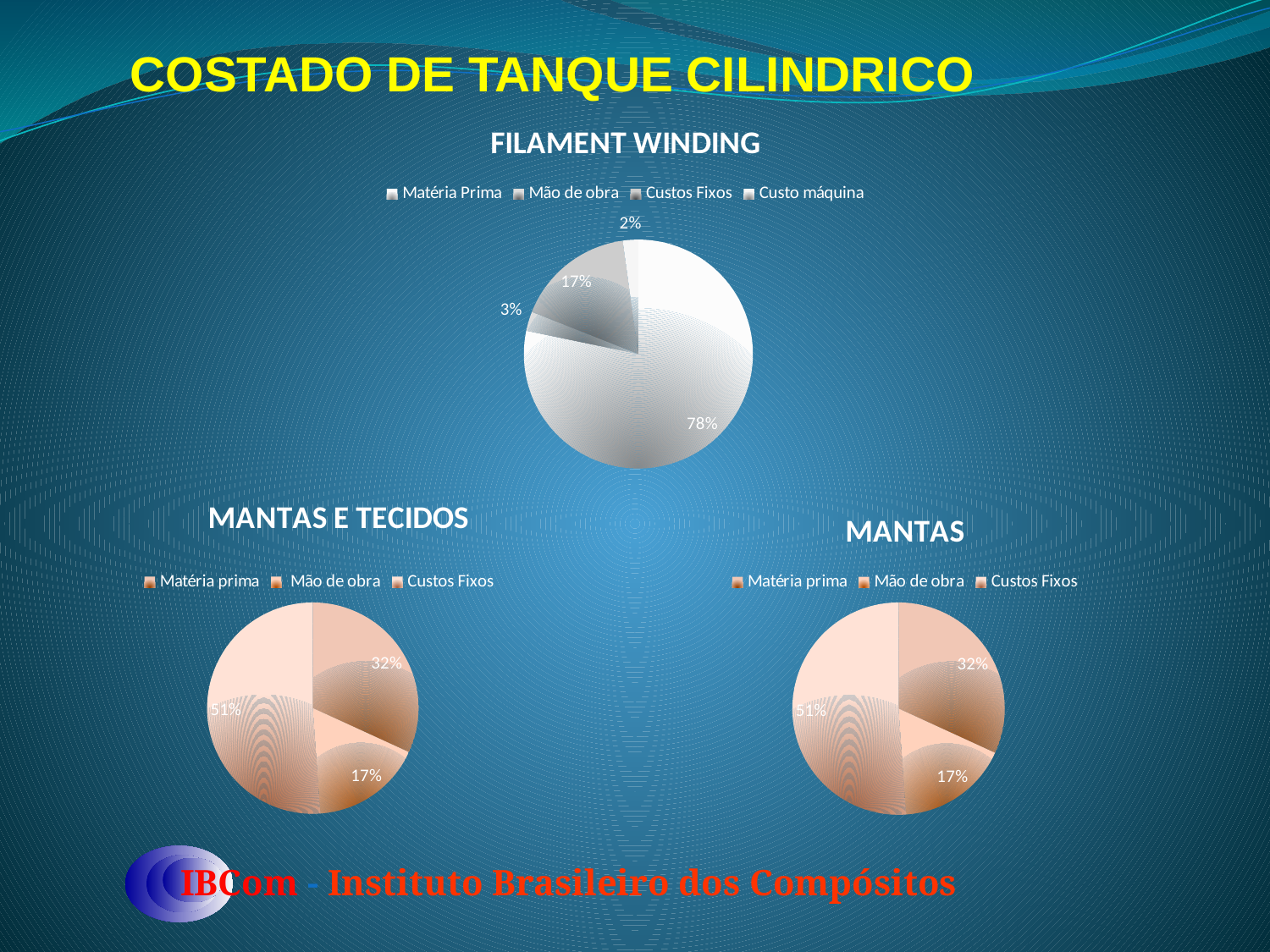
In the MANTAS chart, what share is shown for Matéria prima? 32% How many entries does the legend of the FILAMENT WINDING chart list? 4 In the MANTAS chart, which is larger, the Matéria prima slice or the Mão de obra slice? Matéria prima In the MANTAS E TECIDOS chart, what is the largest slice's share? 51% How many pie charts are shown on the slide? 3 In the FILAMENT WINDING chart, what is the largest slice's share? 78% In the FILAMENT WINDING chart, what share is shown for Matéria Prima? 78% How many entries does the legend of the MANTAS E TECIDOS chart list? 3 In the FILAMENT WINDING chart, what is the difference between the 78% slice and the 17% slice? 61% In the MANTAS E TECIDOS chart, what is the smallest slice's share? 17% What kind of chart is the FILAMENT WINDING chart? pie chart In the FILAMENT WINDING chart, what is the smallest slice's share? 2%